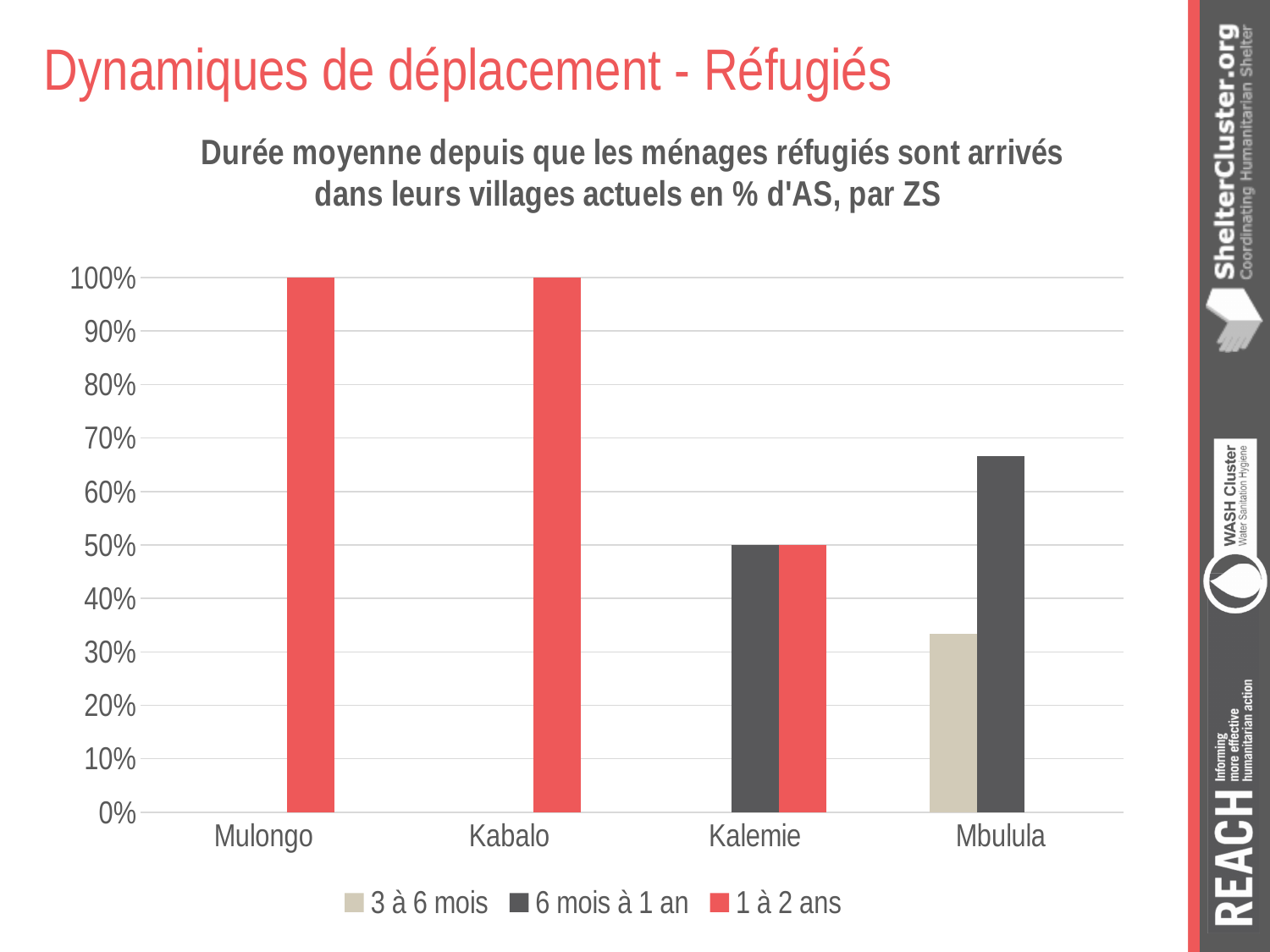
How many series does the legend list? 3 Is the value for '6 mois à 1 an' in Mbulula greater or less than 60%? greater What is the value for '1 à 2 ans' in Mulongo? 100% Which is larger in Mbulula: '3 à 6 mois' or '6 mois à 1 an'? 6 mois à 1 an What is the difference between the '1 à 2 ans' value in Mulongo and the '1 à 2 ans' value in Kalemie? 50% Which zone de santé is the only one with a '3 à 6 mois' bar? Mbulula How many zones de santé (categories) are shown on the x axis? 4 Is the value for '3 à 6 mois' in Mbulula greater or less than 40%? less What is the value for '1 à 2 ans' in Kalemie? 50% What kind of chart is shown on the slide? bar chart What is the value for '1 à 2 ans' in Kabalo? 100% What is the value for '6 mois à 1 an' in Kalemie? 50%